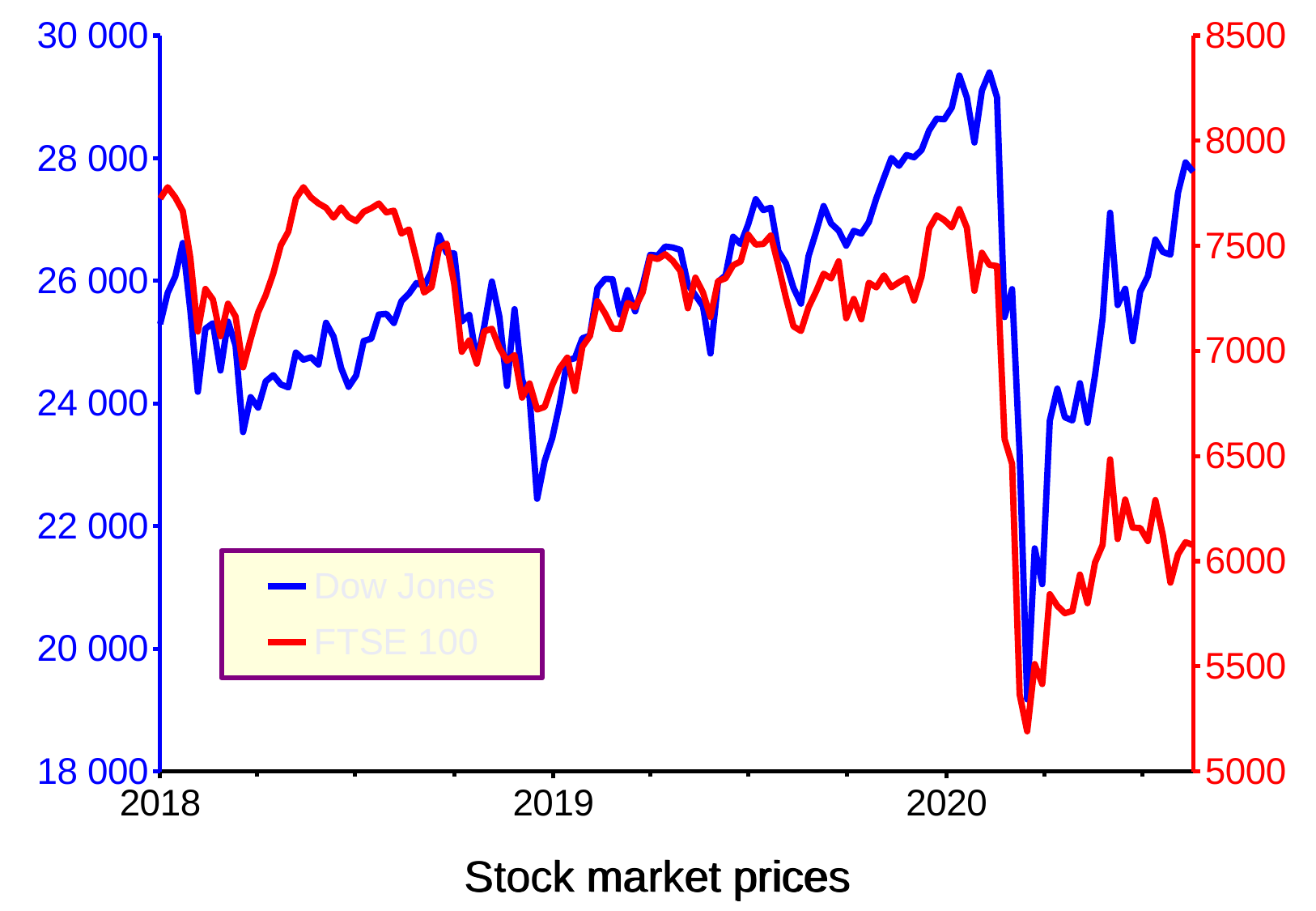
Which colour is used for the FTSE 100 line? red Does the Dow Jones line rise or fall overall from the start of 2019 to the start of 2020? rise What is the title of the chart? Stock market prices Is the Dow Jones value at its peak in early 2020 greater or less than 28 000? greater How many year labels are shown on the x axis? 3 What kind of chart is shown on the slide? line chart Is the Dow Jones value at the start of 2018 greater or less than 24 000? greater Does the FTSE 100 line rise or fall overall from the start of 2018 to the end of the chart? fall Is the FTSE 100 value at the end of the chart greater or less than 6500? less How many series does the legend list? 2